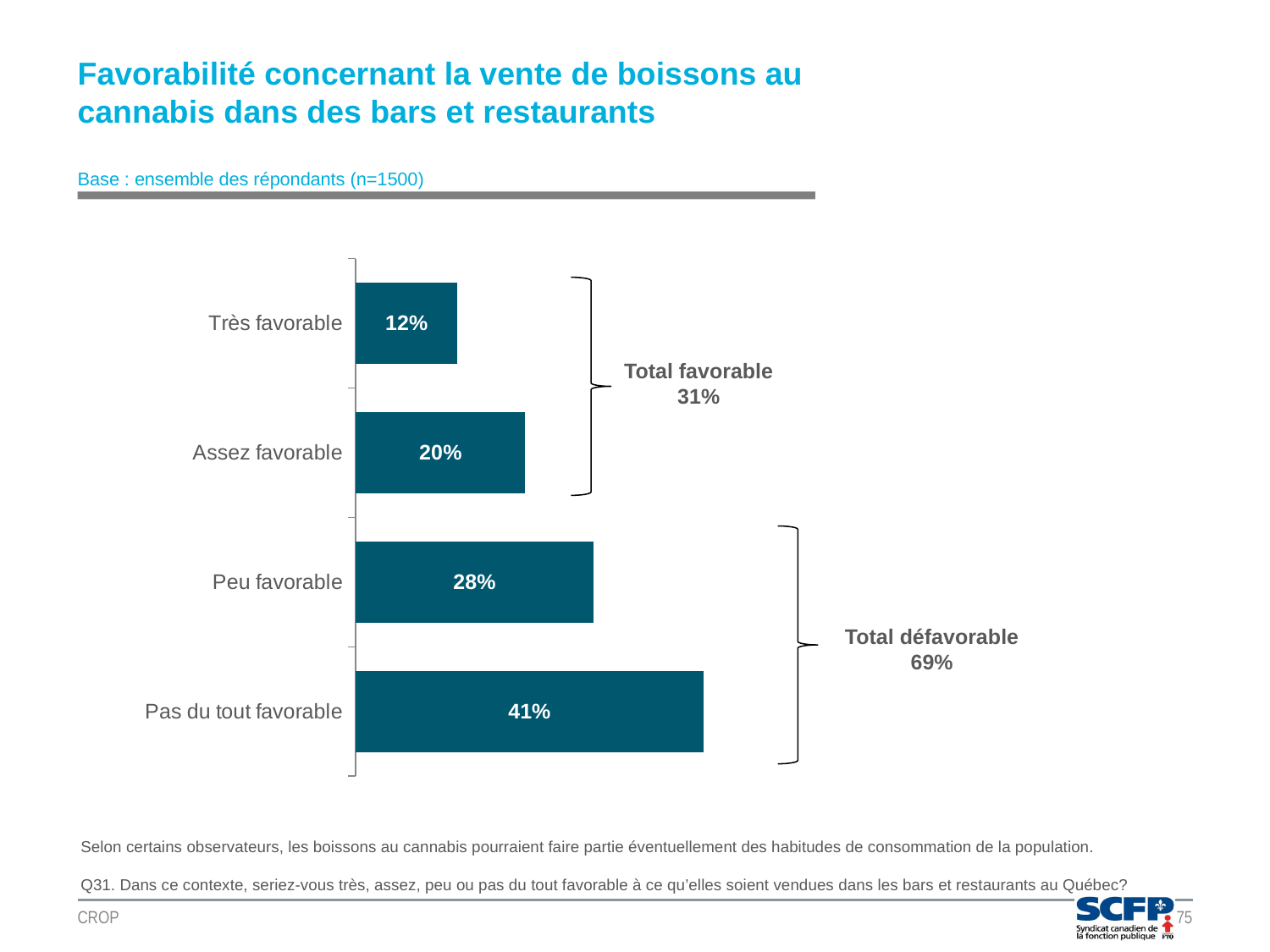
What kind of chart is shown on the slide? Bar chart What is the value for "Assez favorable"? 20% What is the "Total défavorable" value shown on the chart? 69% What is the value for "Très favorable"? 12% Which is larger, "Assez favorable" or "Peu favorable"? Peu favorable What is the "Total favorable" value shown on the chart? 31% What is the value for "Pas du tout favorable"? 41% How many categories are shown in the chart? 4 What is the difference between "Pas du tout favorable" and "Très favorable"? 29% Which category has the lowest value? Très favorable What is the value for "Peu favorable"? 28% Which category has the highest value? Pas du tout favorable